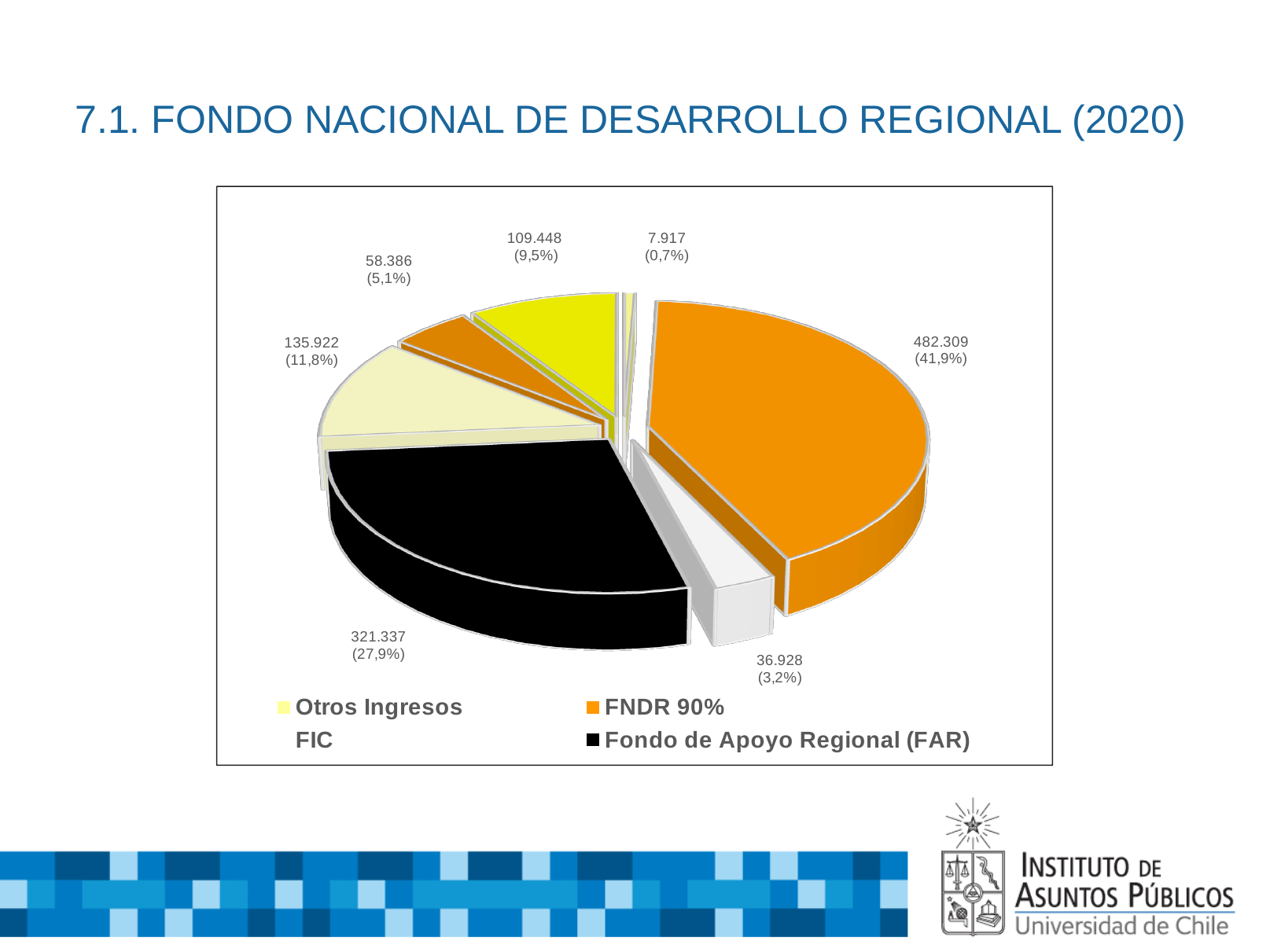
How many slices does the pie chart have? 7 What is the value shown for FNDR 90%? 482.309 Which is larger, the slice for FNDR 90% or the slice for Fondo de Apoyo Regional (FAR)? FNDR 90% What is the value of the smallest slice in the pie chart? 7.917 Which legend category has the largest slice of the pie? FNDR 90% What is the value shown for Fondo de Apoyo Regional (FAR)? 321.337 What share of the pie does Otros Ingresos represent? 0,7% What is the difference between the value for FNDR 90% and the value for Fondo de Apoyo Regional (FAR)? 160.972 How many entries does the legend list? 4 What share of the pie does Fondo de Apoyo Regional (FAR) represent? 27,9% What kind of chart is shown on the slide? pie chart What share of the pie does FNDR 90% represent? 41,9%